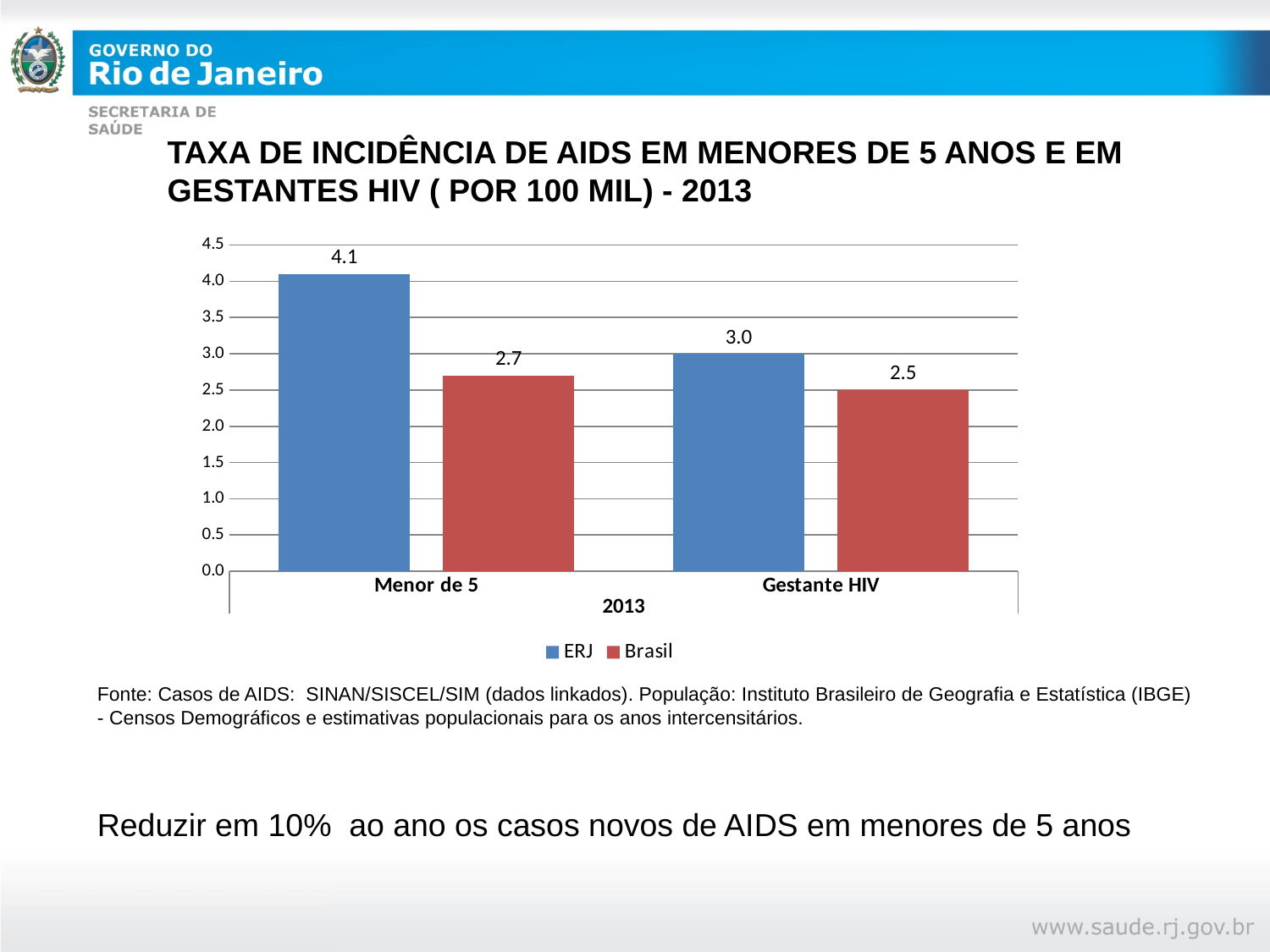
What is the ERJ value for Gestante HIV? 3.0 Which colour represents the Brasil series in the chart? Red What is the difference between the ERJ and Brasil values for Gestante HIV? 0.5 What is the Brasil value for Menor de 5? 2.7 How many series does the legend list? 2 What is the difference between the ERJ and Brasil values for Menor de 5? 1.4 What kind of chart is shown on the slide? Bar chart What is the Brasil value for Gestante HIV? 2.5 Which is larger for Gestante HIV, ERJ or Brasil? ERJ What is the ERJ value for Menor de 5? 4.1 Which bar has the highest value on the chart? ERJ, Menor de 5 Which bar has the lowest value on the chart? Brasil, Gestante HIV